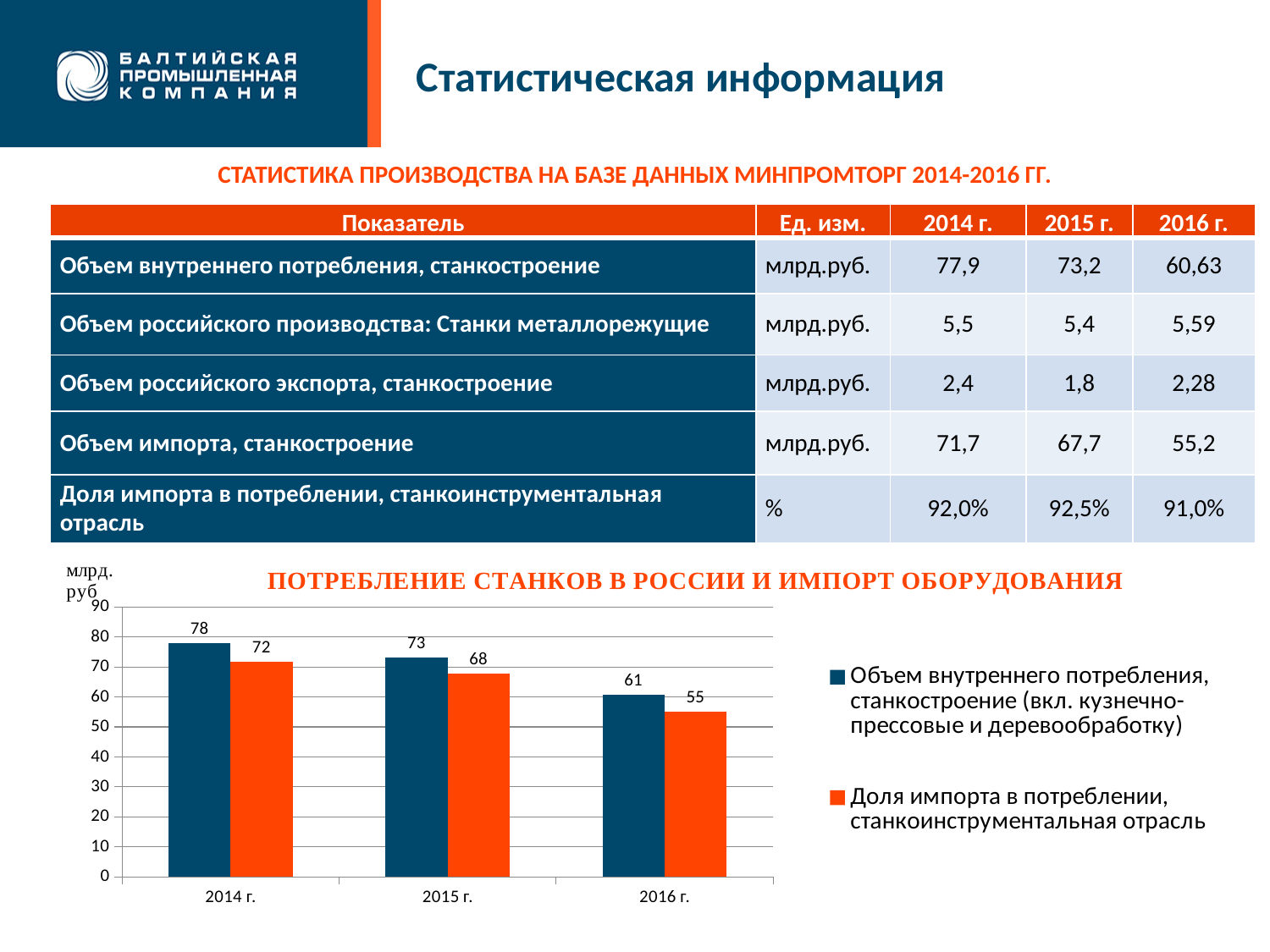
Do the values of the blue series rise or fall from 2014 г. to 2016 г. in the chart? Fall How many series does the chart legend list? 2 What is the value of the orange series (Доля импорта в потреблении) for 2015 г. in the chart? 68 What type of chart is shown on the slide? Bar chart In which year does the orange series (Доля импорта в потреблении) have its lowest value in the chart? 2016 г. In which year does the blue series (Объем внутреннего потребления) reach its highest value in the chart? 2014 г. Which is larger in the chart: the blue bar for 2015 г. or the orange bar for 2014 г.? The blue bar for 2015 г. By how much did the blue series (Объем внутреннего потребления) fall from 2014 г. to 2016 г. in the chart? 17 How many year categories are shown on the x axis of the chart? 3 What is the difference between the blue and orange bars for 2016 г. in the chart? 6 What is the value of the blue series (Объем внутреннего потребления, станкостроение) for 2014 г. in the chart? 78 What is the value of the orange series (Доля импорта в потреблении) for 2016 г. in the chart? 55